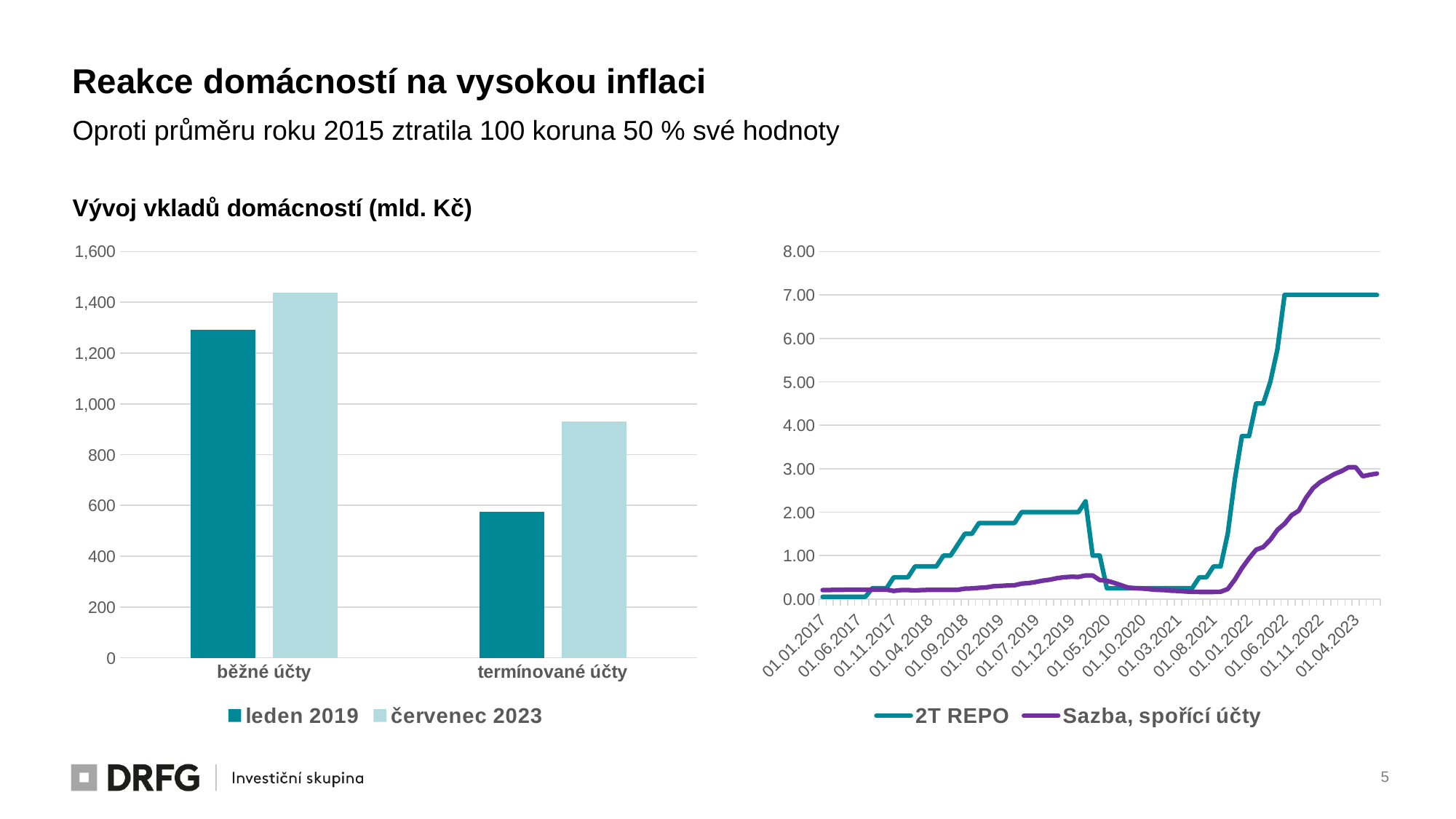
In the left chart 'Vývoj vkladů domácností (mld. Kč)', which is larger for běžné účty: leden 2019 or červenec 2023? červenec 2023 What kind of chart is the right chart with the 2T REPO series? line chart In the left chart 'Vývoj vkladů domácností (mld. Kč)', which category has the lowest bar overall? termínované účty In the right chart, how many series does the legend list? 2 What kind of chart is the left chart titled 'Vývoj vkladů domácností (mld. Kč)'? bar chart In the left chart 'Vývoj vkladů domácností (mld. Kč)', is the value for běžné účty in červenec 2023 greater or less than 1,400? greater In the left chart 'Vývoj vkladů domácností (mld. Kč)', is the value for termínované účty in leden 2019 greater or less than 600? less In the right chart, is the value of Sazba, spořící účty at 01.04.2023 greater or less than 2.00? greater In the left chart 'Vývoj vkladů domácností (mld. Kč)', how many categories are shown on the x axis? 2 In the right chart, what value does the 2T REPO line reach at its plateau from mid-2022 onward? 7.00 In the left chart 'Vývoj vkladů domácností (mld. Kč)', how many series does the legend list? 2